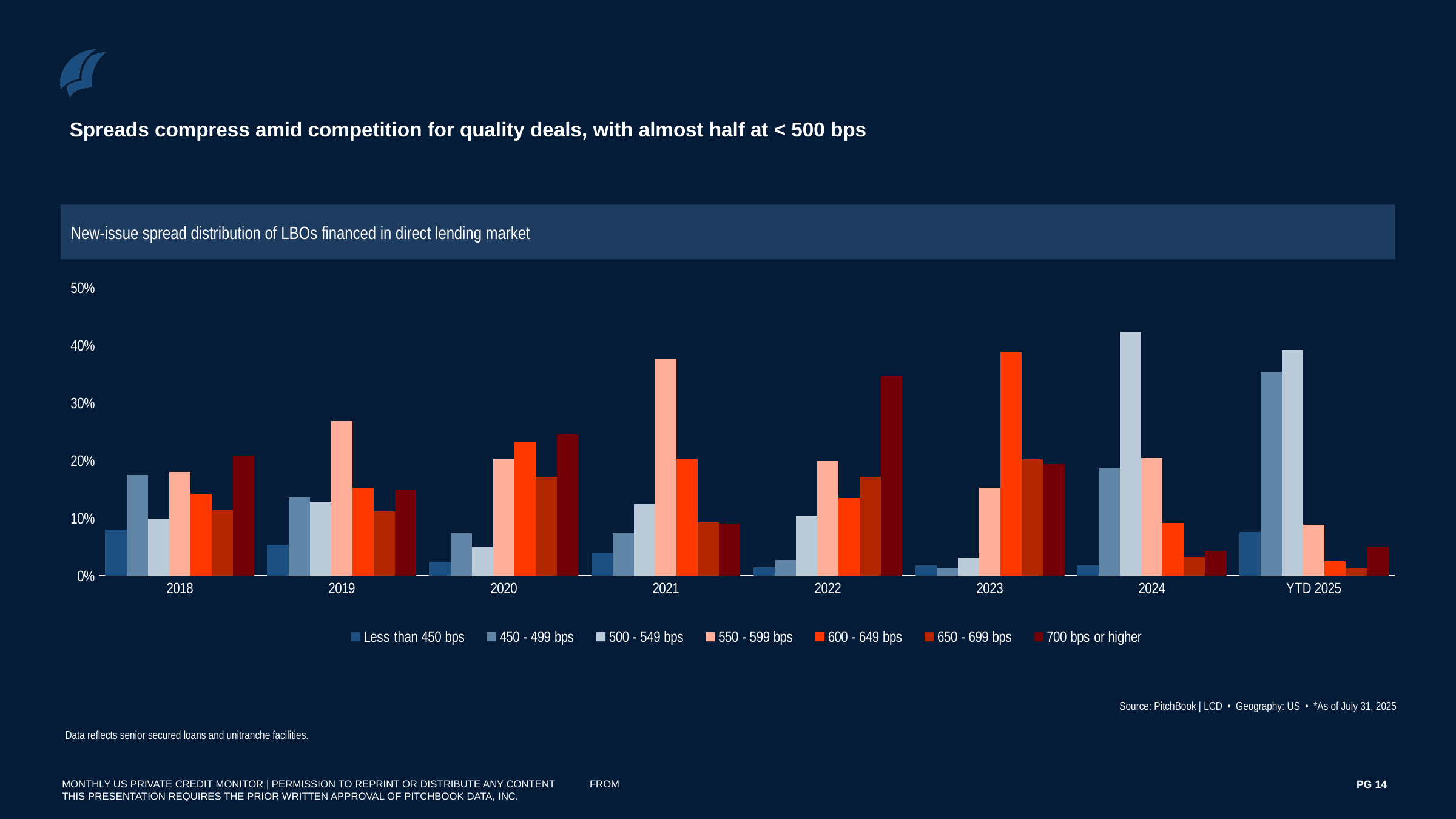
Does the share for 500 - 549 bps rise or fall from 2022 to 2024? rises How many series does the legend list? 7 Is the value for 500 - 549 bps in 2024 greater or less than 40%? greater What is the title of the chart? New-issue spread distribution of LBOs financed in direct lending market Is the value for Less than 450 bps in 2022 greater or less than 10%? less Which spread bucket has the highest share in 2022? 700 bps or higher How many year categories are shown on the x axis? 8 Which spread bucket has the highest share in 2023? 600 - 649 bps Is the value for 550 - 599 bps in 2021 greater or less than 30%? greater What kind of chart is shown on the slide? Bar chart In YTD 2025, which is larger: 450 - 499 bps or 500 - 549 bps? 500 - 549 bps